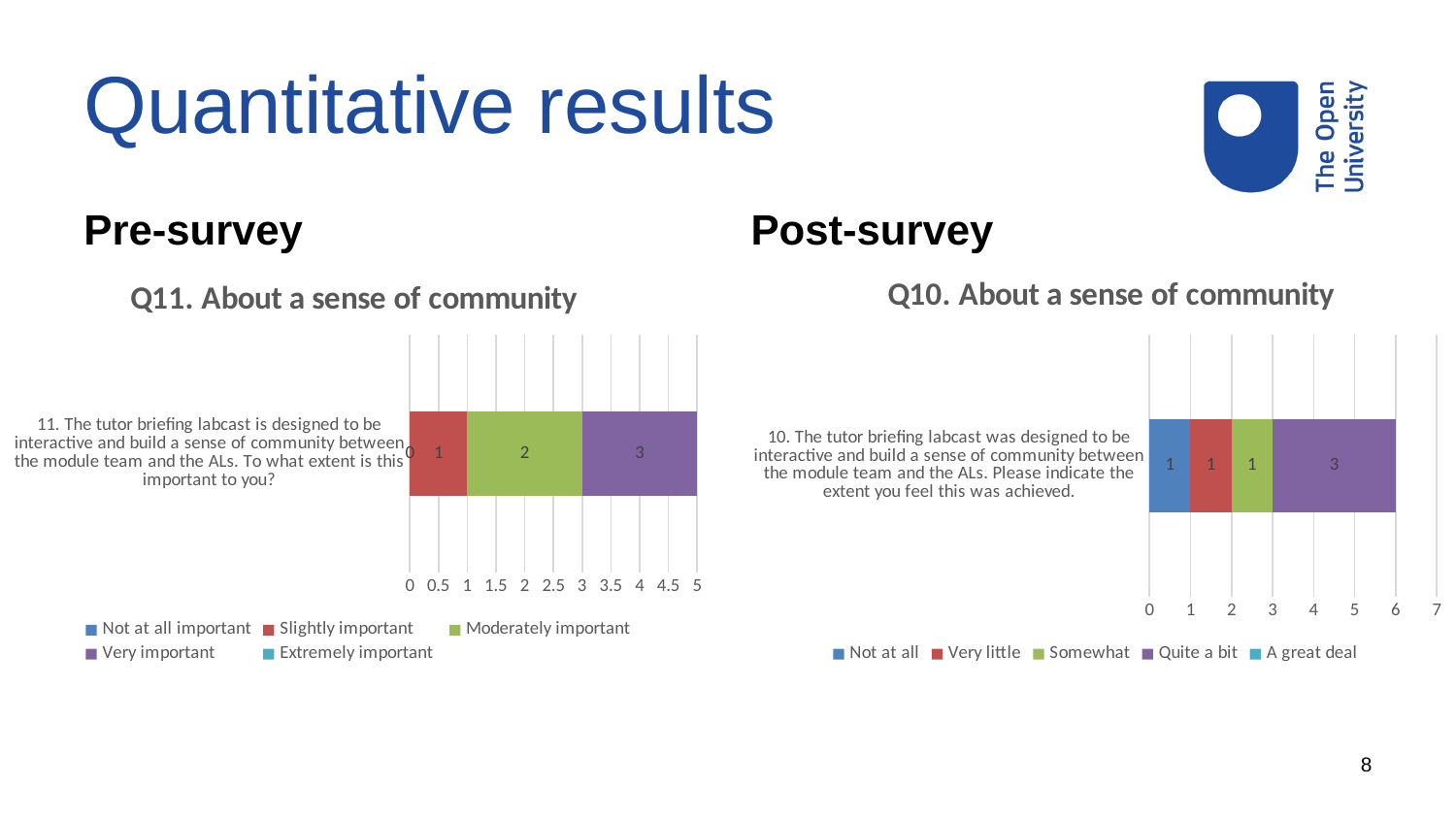
In the Q11. About a sense of community chart, what is the value for Moderately important? 2 What type of chart is the Q11. About a sense of community chart? Stacked bar chart In the Q10. About a sense of community chart, which response category has the highest value? Quite a bit In the Q10. About a sense of community chart, how many series does the legend list? 5 In the Q11. About a sense of community chart, what is the value for Very important? 3 In the Q10. About a sense of community chart, what is the total of the stacked bar using the printed data labels? 6 In the Q10. About a sense of community chart, what is the value for Not at all? 1 In the Q10. About a sense of community chart, what is the difference between the values for Quite a bit and Somewhat? 2 In the Q10. About a sense of community chart, what is the value for Quite a bit? 3 In the Q11. About a sense of community chart, what is the difference between the values for Very important and Slightly important? 2 In the Q11. About a sense of community chart, what is the value for Slightly important? 1 In the Q11. About a sense of community chart, which labelled response category has the highest value? Very important